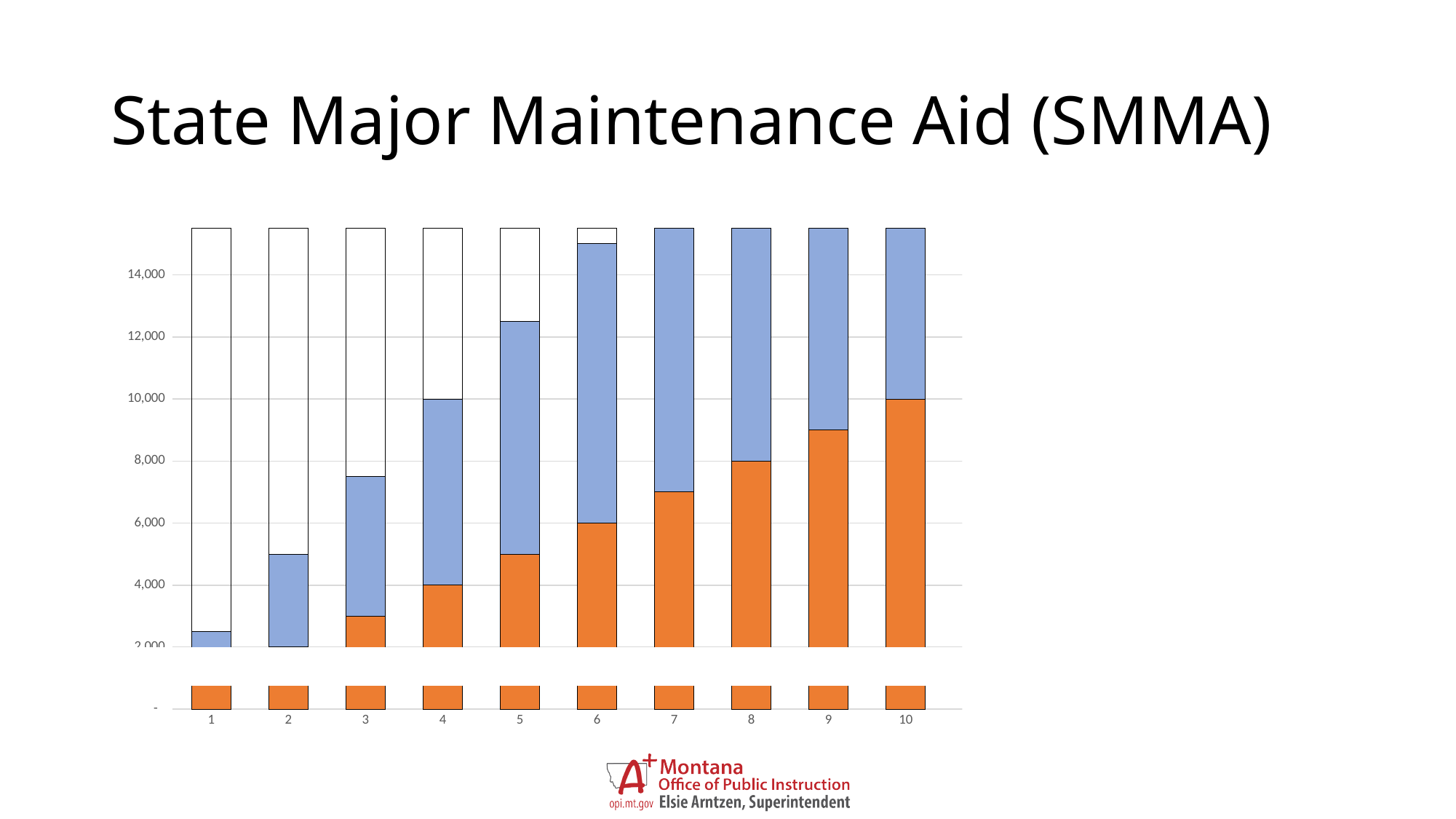
What is the value of the orange segment for category 8? 8,000 What kind of chart is shown on the slide? Stacked bar chart How many categories are shown along the x axis? 10 Do the orange segments rise or fall from category 1 to category 10? Rise What is the value of the orange segment for category 10? 10,000 Which category has the shortest orange segment? 1 Is the orange segment for category 3 greater or less than 4,000? less Which category has the tallest orange segment? 10 What is the title of the slide's chart? State Major Maintenance Aid (SMMA) Which has the larger orange segment, category 8 or category 3? Category 8 What is the value of the orange segment for category 4? 4,000 Is the orange segment for category 7 greater or less than 6,000? greater